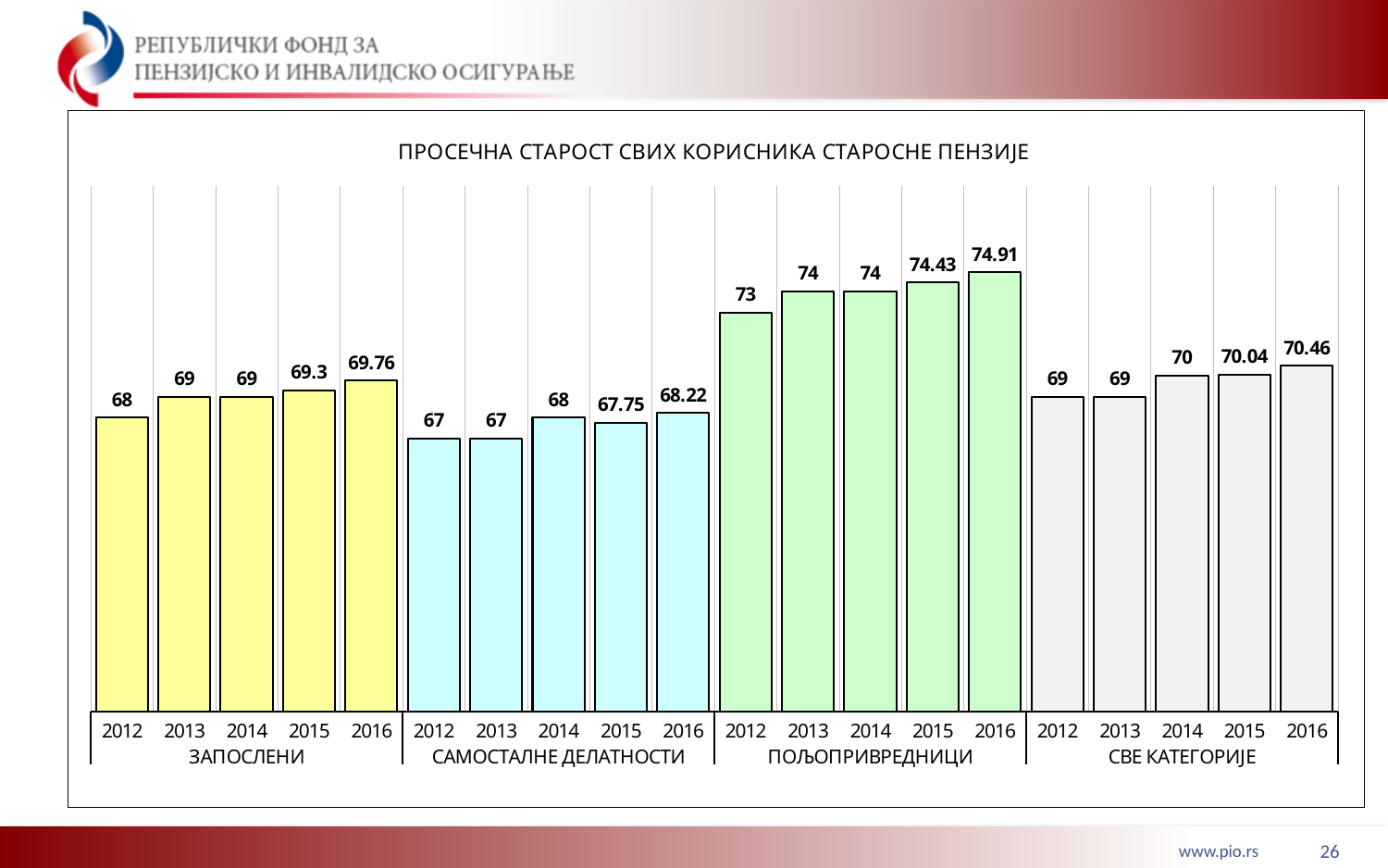
Which is larger: the 2015 value for СВЕ КАТЕГОРИЈЕ or the 2015 value for ЗАПОСЛЕНИ? СВЕ КАТЕГОРИЈЕ What is the title of the chart? ПРОСЕЧНА СТАРОСТ СВИХ КОРИСНИКА СТАРОСНЕ ПЕНЗИЈЕ What is the difference between the 2016 values for ПОЉОПРИВРЕДНИЦИ and ЗАПОСЛЕНИ? 5.15 What is the value for САМОСТАЛНЕ ДЕЛАТНОСТИ in 2014? 68 Do the values for ПОЉОПРИВРЕДНИЦИ rise or fall from 2012 to 2016? Rise What is the average age for ЗАПОСЛЕНИ in 2016? 69.76 Which category group has the lowest bar on the chart? САМОСТАЛНЕ ДЕЛАТНОСТИ What is the value for СВЕ КАТЕГОРИЈЕ in 2016? 70.46 What is the value for ПОЉОПРИВРЕДНИЦИ in 2015? 74.43 How many bars are plotted on the chart in total? 20 Which category group has the highest bar on the chart? ПОЉОПРИВРЕДНИЦИ What kind of chart is shown on the slide? Bar chart